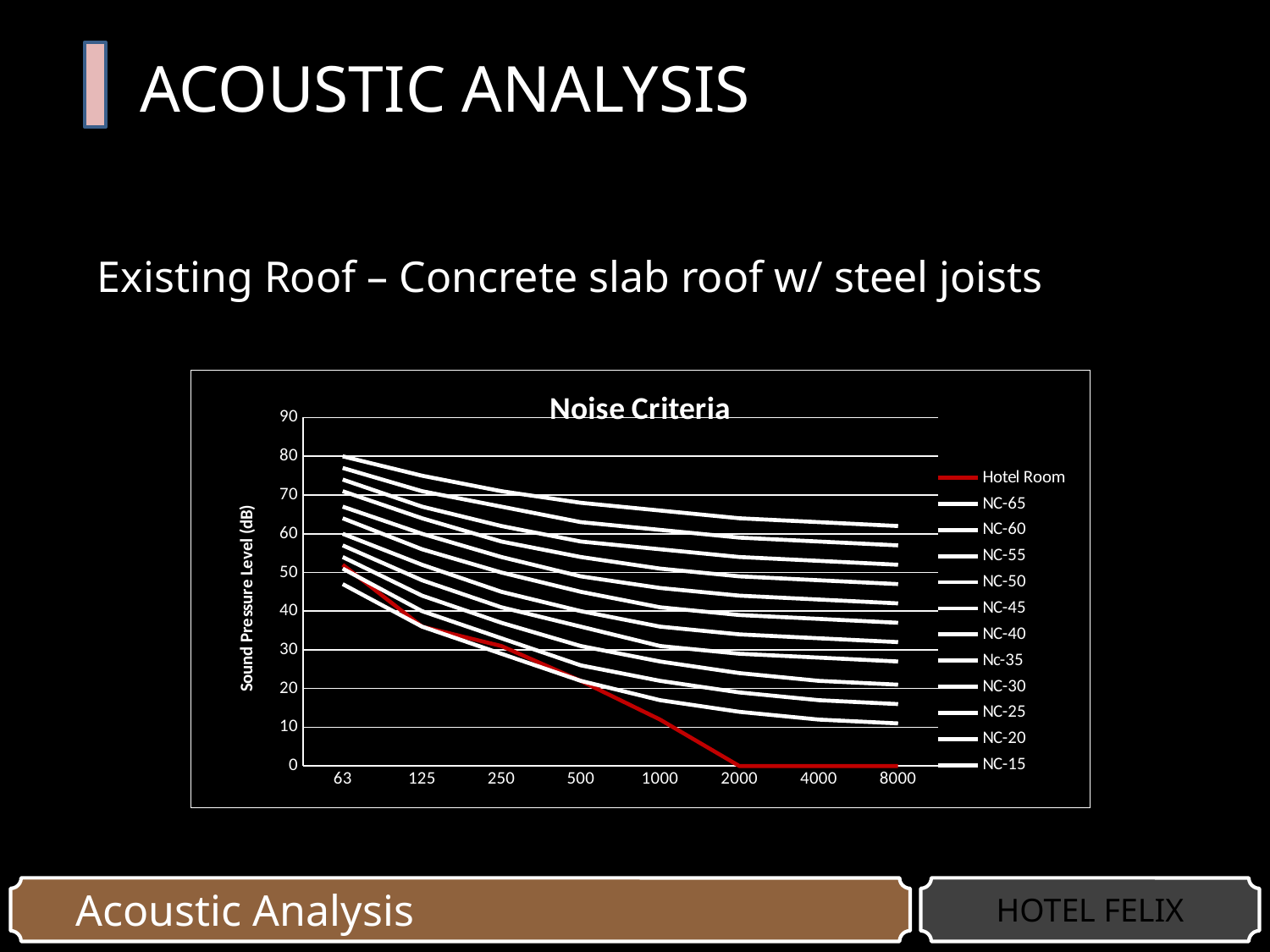
Is the Hotel Room value at 1000 greater or less than 20? less Is the Hotel Room value at 63 greater or less than 60? less What is the Hotel Room value at 8000? 0 Does the Hotel Room line rise or fall as frequency increases along the x axis? fall What is the label of the vertical axis? Sound Pressure Level (dB) What is the title of the chart? Noise Criteria Which series has the highest value at 63? NC-65 How many frequency categories are shown on the x axis? 8 Is the NC-65 value at 8000 greater or less than 50? greater How many series does the chart legend list? 12 What is the Hotel Room value at 2000? 0 What type of chart is shown on the slide? line chart